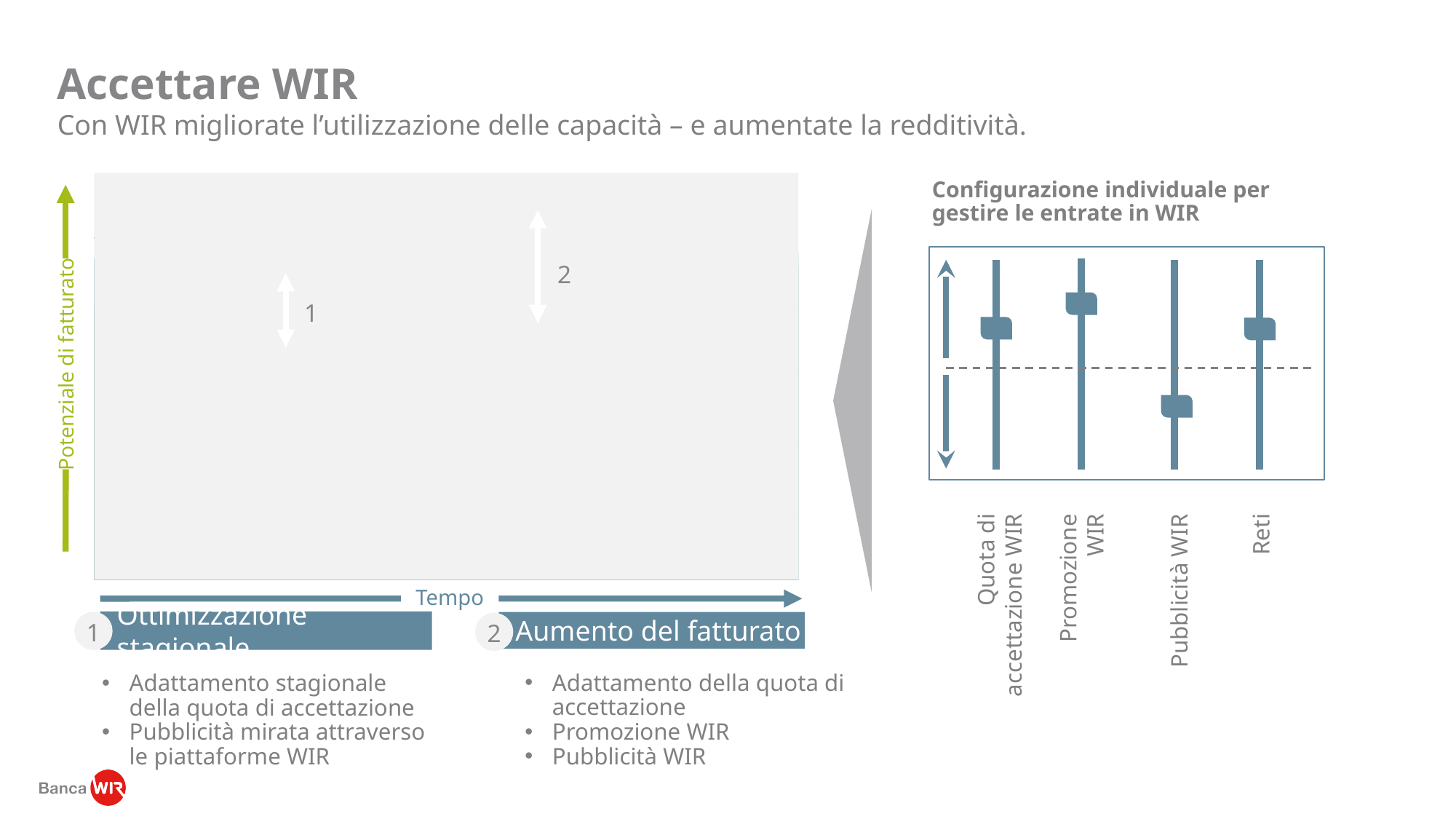
In the slider diagram on the right, which slider is the only one set below the dashed line? Pubblicità WIR In the slider diagram on the right, which slider is set to the lowest position? Pubblicità WIR In the slider diagram on the right, which slider is set higher: Promozione WIR or Quota di accettazione WIR? Promozione WIR In the slider diagram on the right, how many sliders are shown? 4 In the left chart, what is the label on the vertical axis? Potenziale di fatturato In the slider diagram on the right, which slider is set higher: Reti or Pubblicità WIR? Reti In the left chart, what is the label on the horizontal axis? Tempo In the slider diagram on the right, how many sliders are set below the dashed line? 1 In the slider diagram on the right, which slider is set to the highest position? Promozione WIR